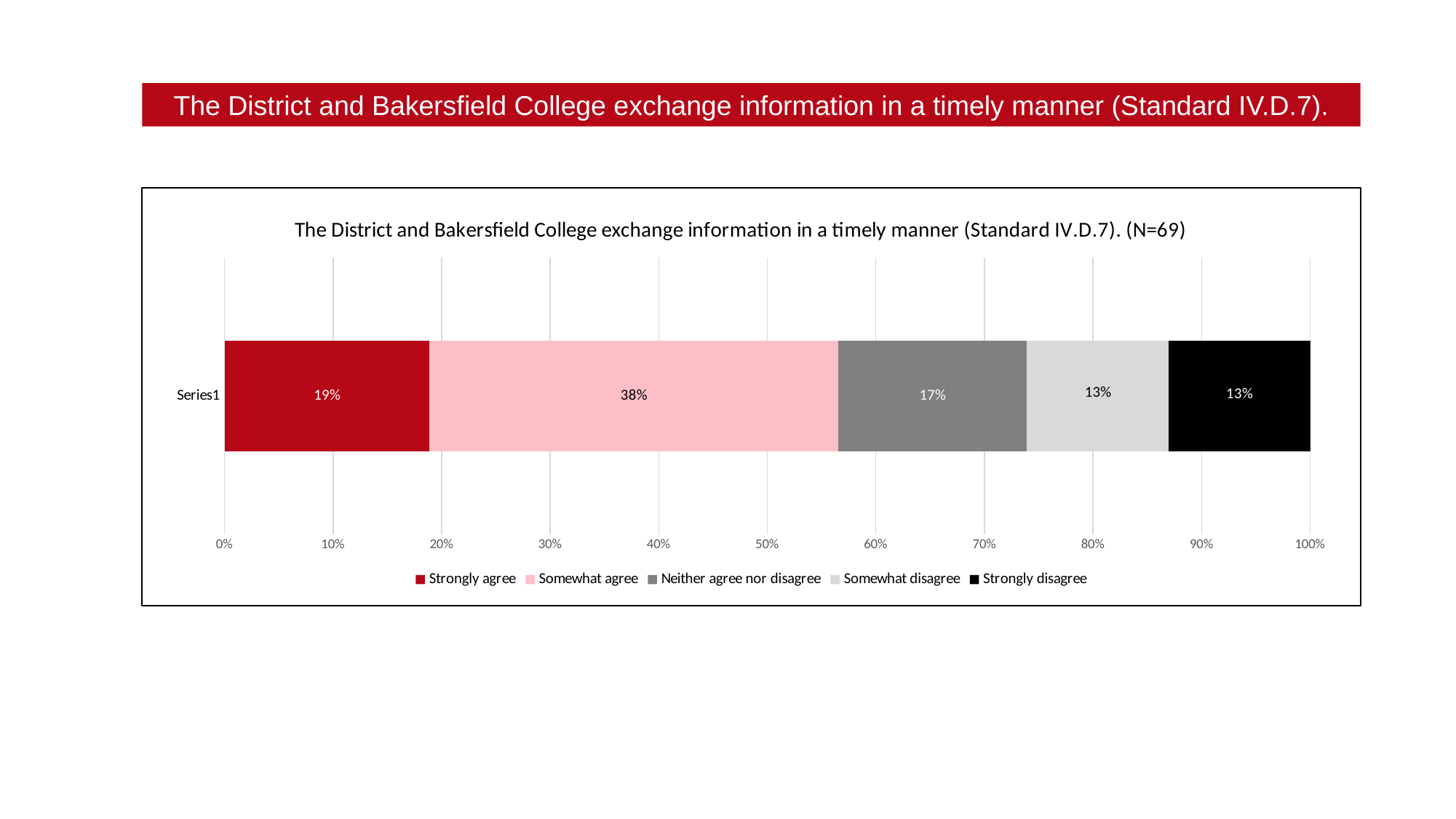
What percentage of respondents selected "Strongly disagree"? 13% Which colour represents "Strongly disagree" in the chart? Black What is the sample size (N) given in the chart title? 69 What kind of chart is shown on the slide? Stacked bar chart What percentage of respondents selected "Neither agree nor disagree"? 17% What percentage of respondents selected "Strongly agree"? 19% What is the difference between the "Somewhat agree" and "Strongly agree" percentages? 19% Which response category has the largest share? Somewhat agree What is the combined percentage of "Strongly agree" and "Somewhat agree" responses? 57% How many series does the legend list? 5 Which is larger, the "Strongly agree" share or the "Neither agree nor disagree" share? Strongly agree What percentage of respondents selected "Somewhat agree"? 38%